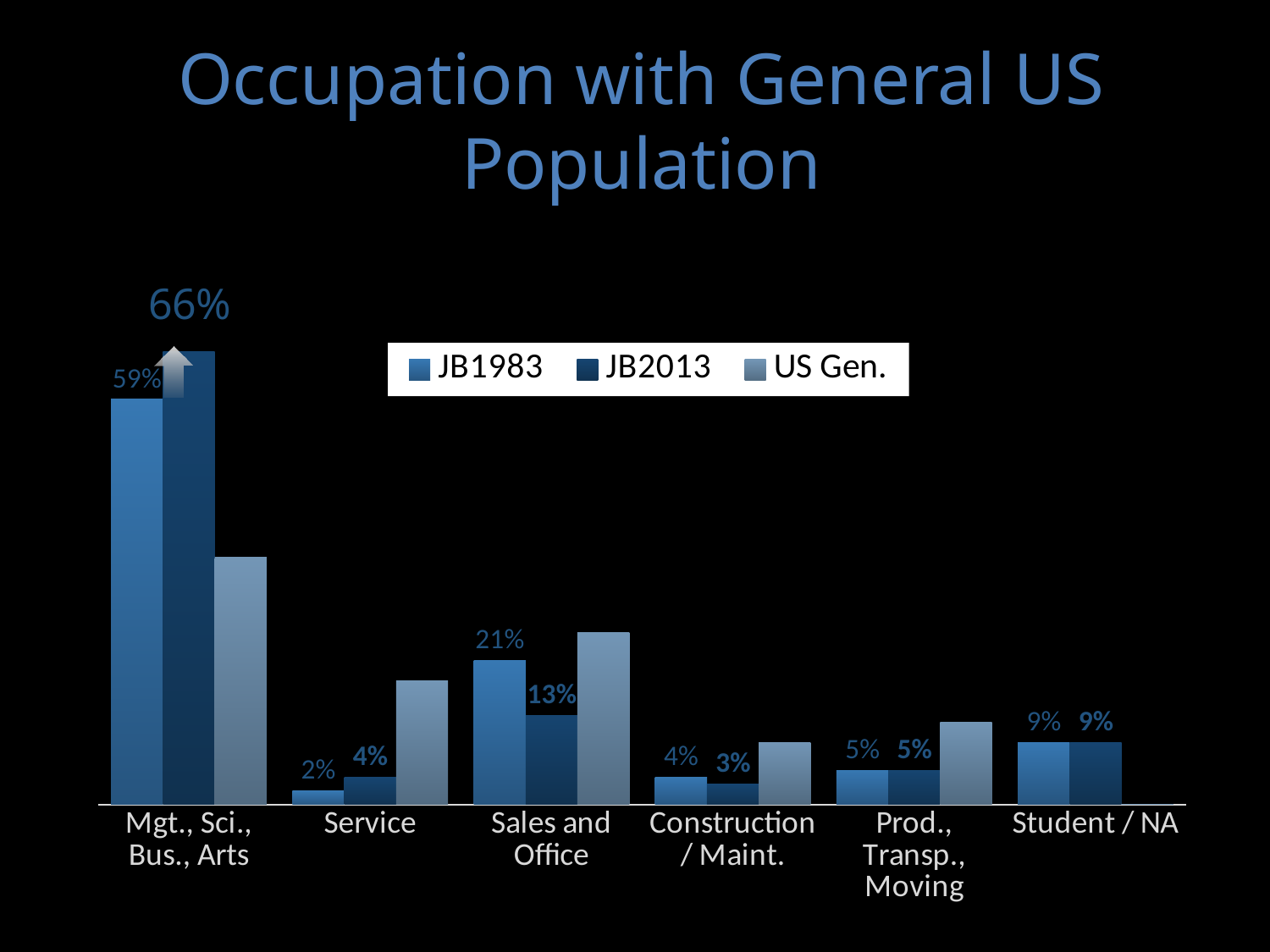
What is the difference between the JB1983 and JB2013 values for Sales and Office? 8% What is the JB2013 value for Service? 4% Which series is shown in the lightest blue in the legend? US Gen. What is the JB1983 value for Sales and Office? 21% What kind of chart is shown on the slide? bar chart Which category has the highest JB1983 value? Mgt., Sci., Bus., Arts What is the JB2013 value for Mgt., Sci., Bus., Arts? 66% Which category has the lowest JB1983 value? Service How many series does the legend list? 3 How many occupation categories are shown on the x axis? 6 Which is larger for Mgt., Sci., Bus., Arts: the JB1983 value or the JB2013 value? JB2013 What is the title of the chart? Occupation with General US Population